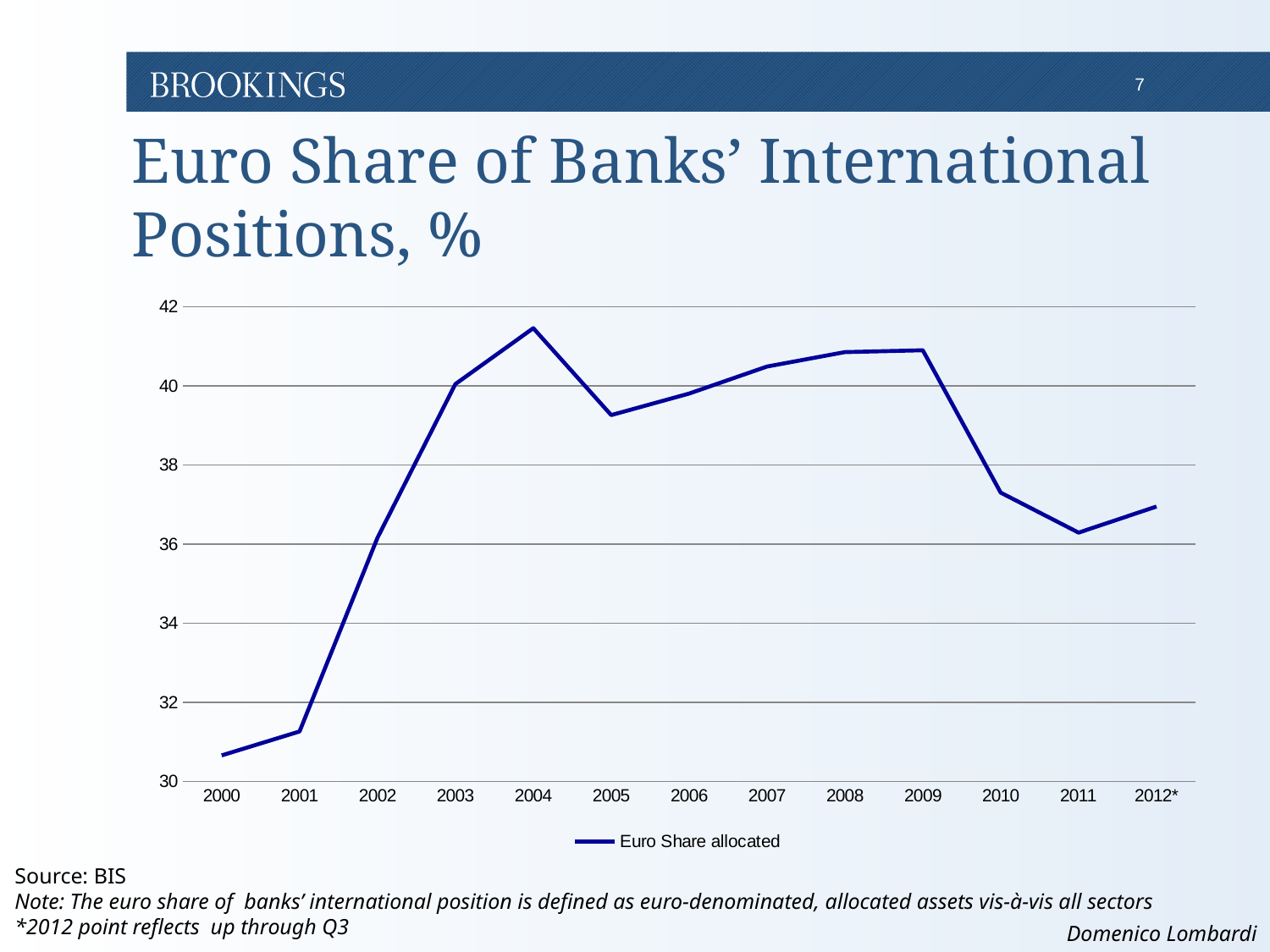
Which is larger, the value for 2010 or the value for 2011? 2010 What kind of chart is shown on the slide? Line chart Is the value for 2004 greater or less than 40? greater Which is larger, the value for 2004 or the value for 2005? 2004 Which year has the highest euro share of banks' international positions? 2004 Does the euro share rise or fall from 2000 to 2004? Rise Which year has the lowest euro share of banks' international positions? 2000 Is the value for 2010 greater or less than 38? less Is the value for 2000 greater or less than 32? less How many years are plotted on the x axis? 13 What series name does the legend show? Euro Share allocated